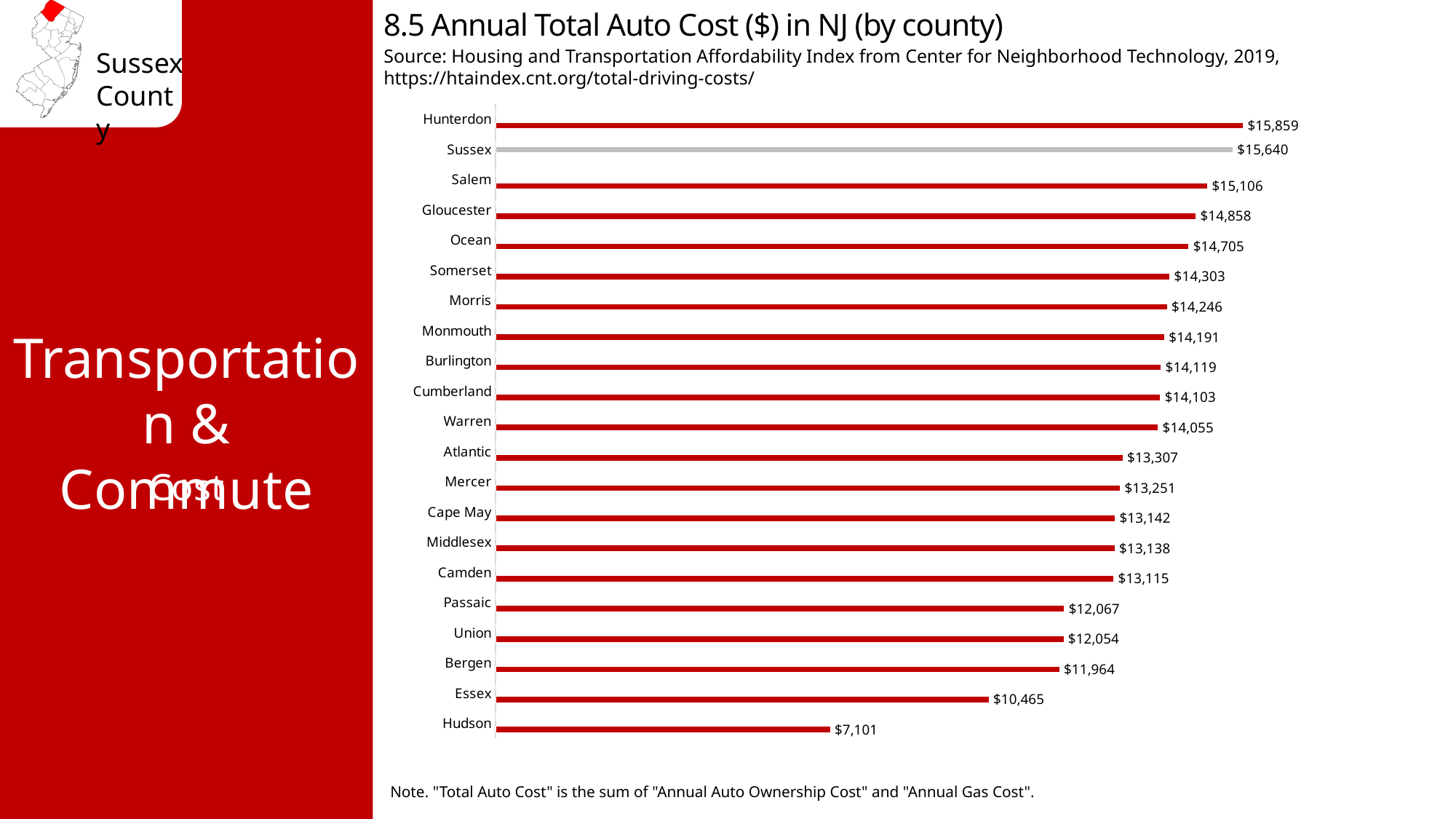
What is the difference in annual total auto cost between Essex and Hudson? $3,364 Which county has the lowest annual total auto cost? Hudson What is the difference in annual total auto cost between Hunterdon and Sussex? $219 Which county has the highest annual total auto cost? Hunterdon Which has a higher annual total auto cost, Salem or Gloucester? Salem Which has a higher annual total auto cost, Bergen or Passaic? Passaic What is the annual total auto cost for Sussex County? $15,640 What is the annual total auto cost for Morris County? $14,246 Which county's bar is shown in gray rather than red? Sussex What type of chart is used to show annual total auto cost by county? Bar chart How many counties are shown in the chart? 21 What is the annual total auto cost for Hudson County? $7,101